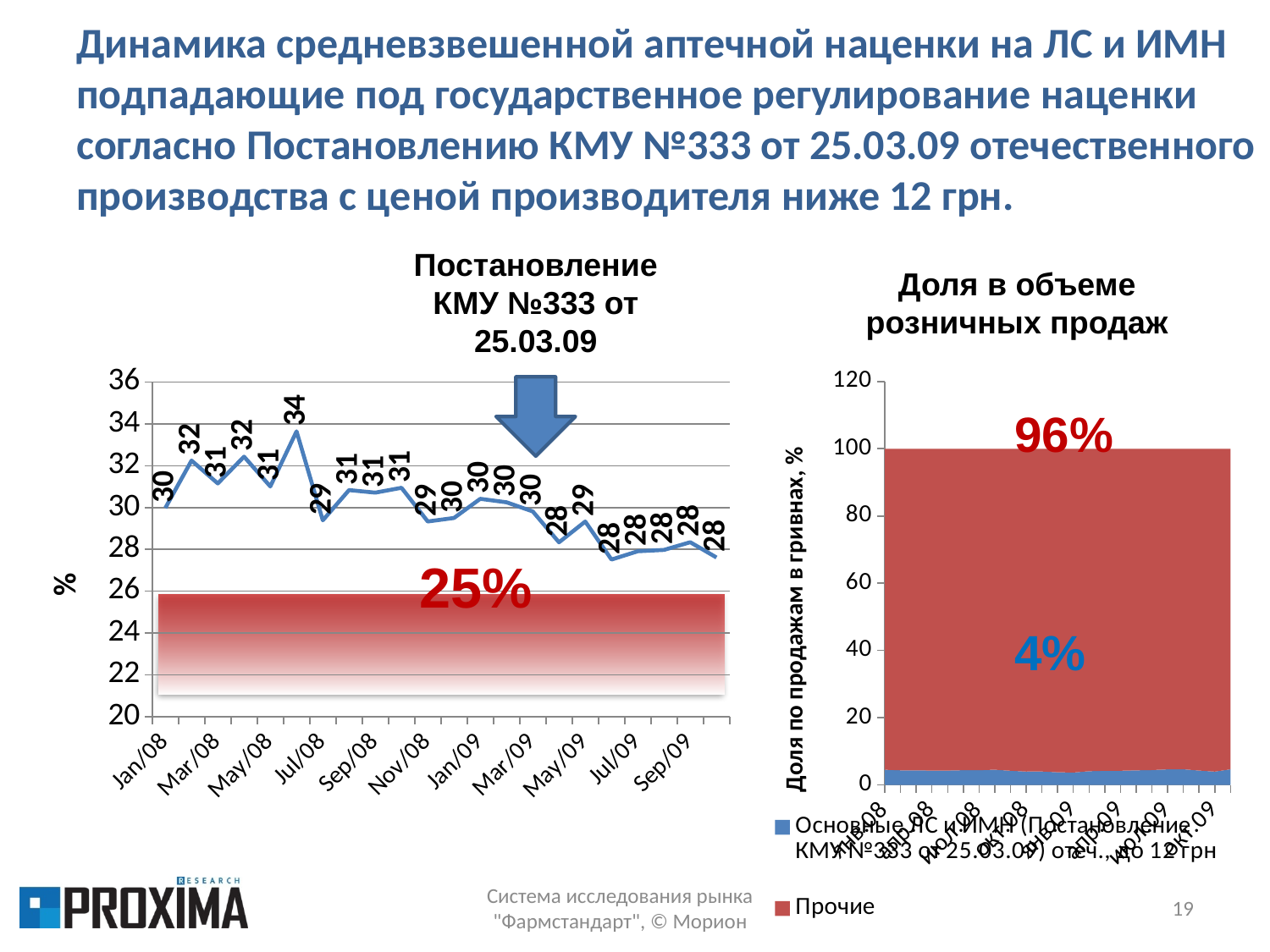
On the left line chart, what is the difference between the highest labelled value (34) and the lowest labelled value (28)? 6 On the left line chart, what is the value for Sep/09? 28 On the left line chart, do the values generally rise or fall from Jan/08 to Sep/09? fall On the right chart 'Доля в объеме розничных продаж', what share is labelled for 'Прочие'? 96% On the left line chart, what is the lowest data label shown? 28 What kind of chart is the left chart showing the markup dynamics in %? line chart On the left line chart, what is the value for Jan/09? 30 On the left line chart, what is the highest data label shown? 34 On the left line chart, is the value for Sep/09 greater or less than 26? greater On the right chart 'Доля в объеме розничных продаж', how many series does the legend list? 2 On the left line chart, what is the value for Jan/08? 30 On the left line chart, which is larger: the value for Jan/08 or the value for Sep/09? Jan/08